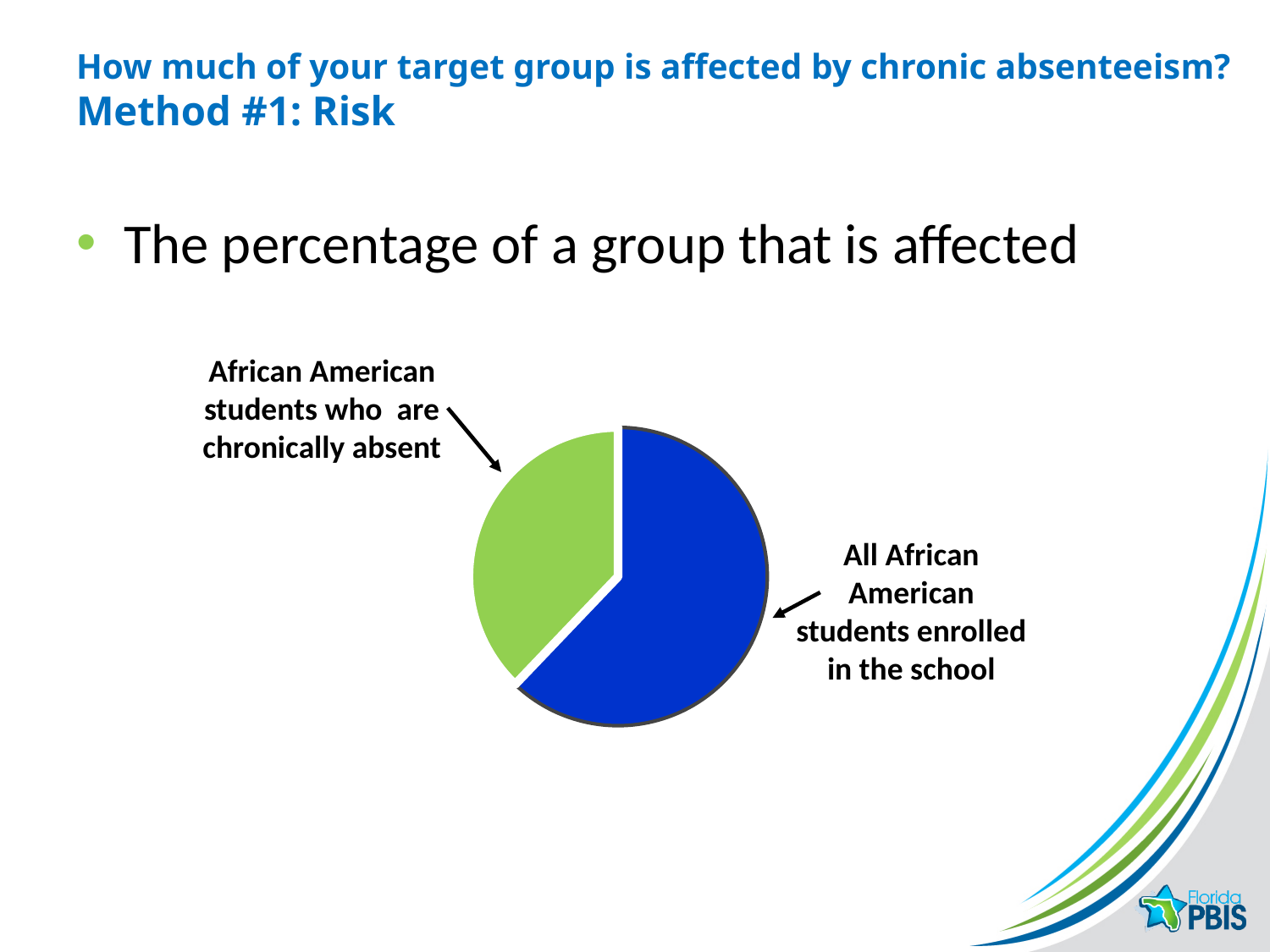
Which slice of the pie chart is larger: the one for African American students who are chronically absent or the one for all African American students enrolled in the school? All African American students enrolled in the school What colour is the slice labelled 'All African American students enrolled in the school'? blue How many slices does the pie chart have? 2 What kind of chart is shown on the slide? pie chart What colour is the slice labelled 'African American students who are chronically absent'? green Which slice of the pie chart is the largest? All African American students enrolled in the school Which slice of the pie chart is the smallest? African American students who are chronically absent